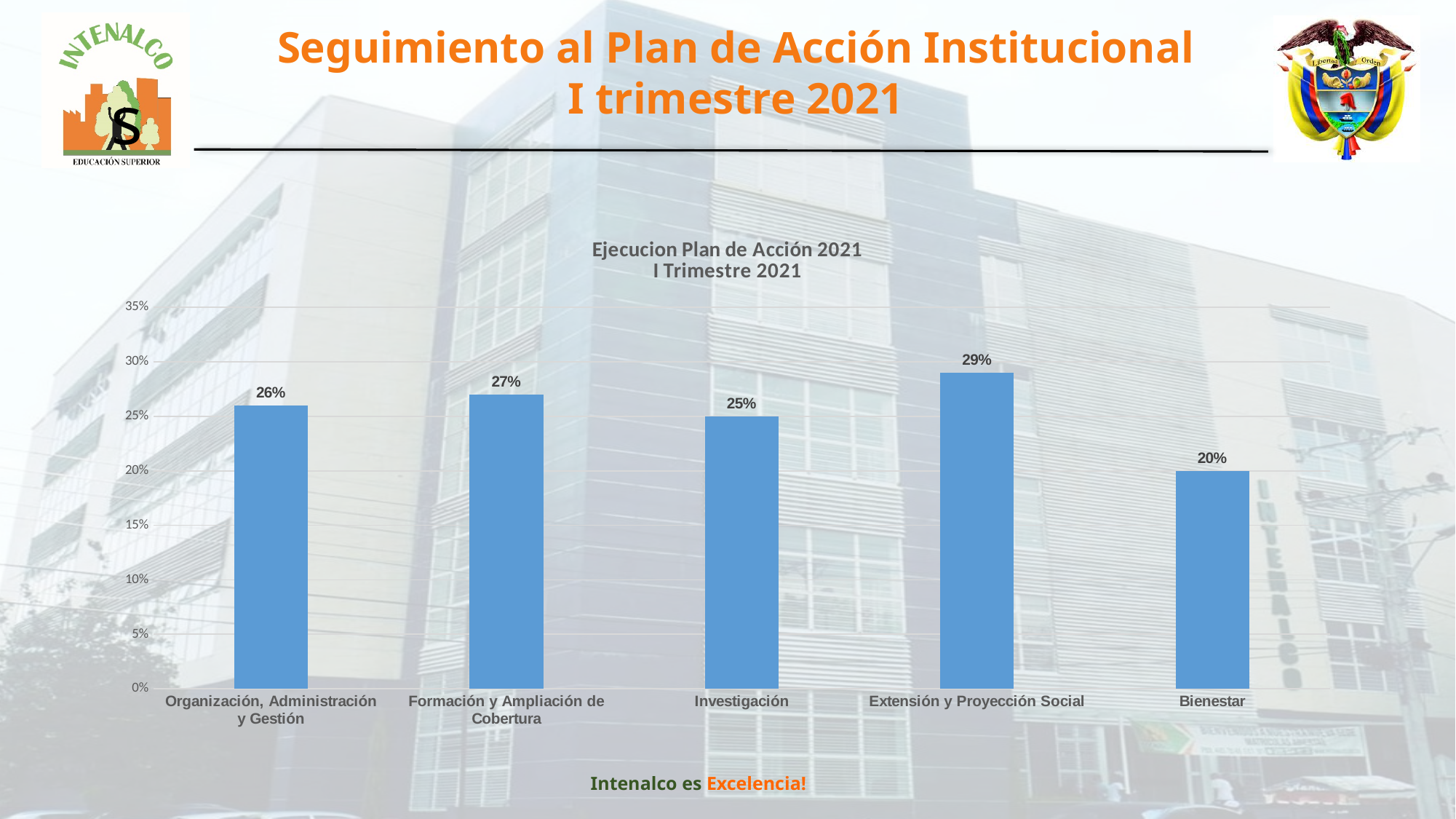
What is the value for Investigación? 25% What is the difference between the values for Extensión y Proyección Social and Bienestar? 9% Which category has the highest value? Extensión y Proyección Social Which category has the lowest value? Bienestar What is the difference between the values for Formación y Ampliación de Cobertura and Organización, Administración y Gestión? 1% What is the value for Bienestar? 20% What is the value for Formación y Ampliación de Cobertura? 27% What kind of chart is shown on the slide? bar chart Is the value for Extensión y Proyección Social greater or less than 30%? less Which is larger, the value for Organización, Administración y Gestión or the value for Investigación? Organización, Administración y Gestión How many categories are shown in the chart? 5 What is the title of the chart? Ejecucion Plan de Acción 2021 I Trimestre 2021